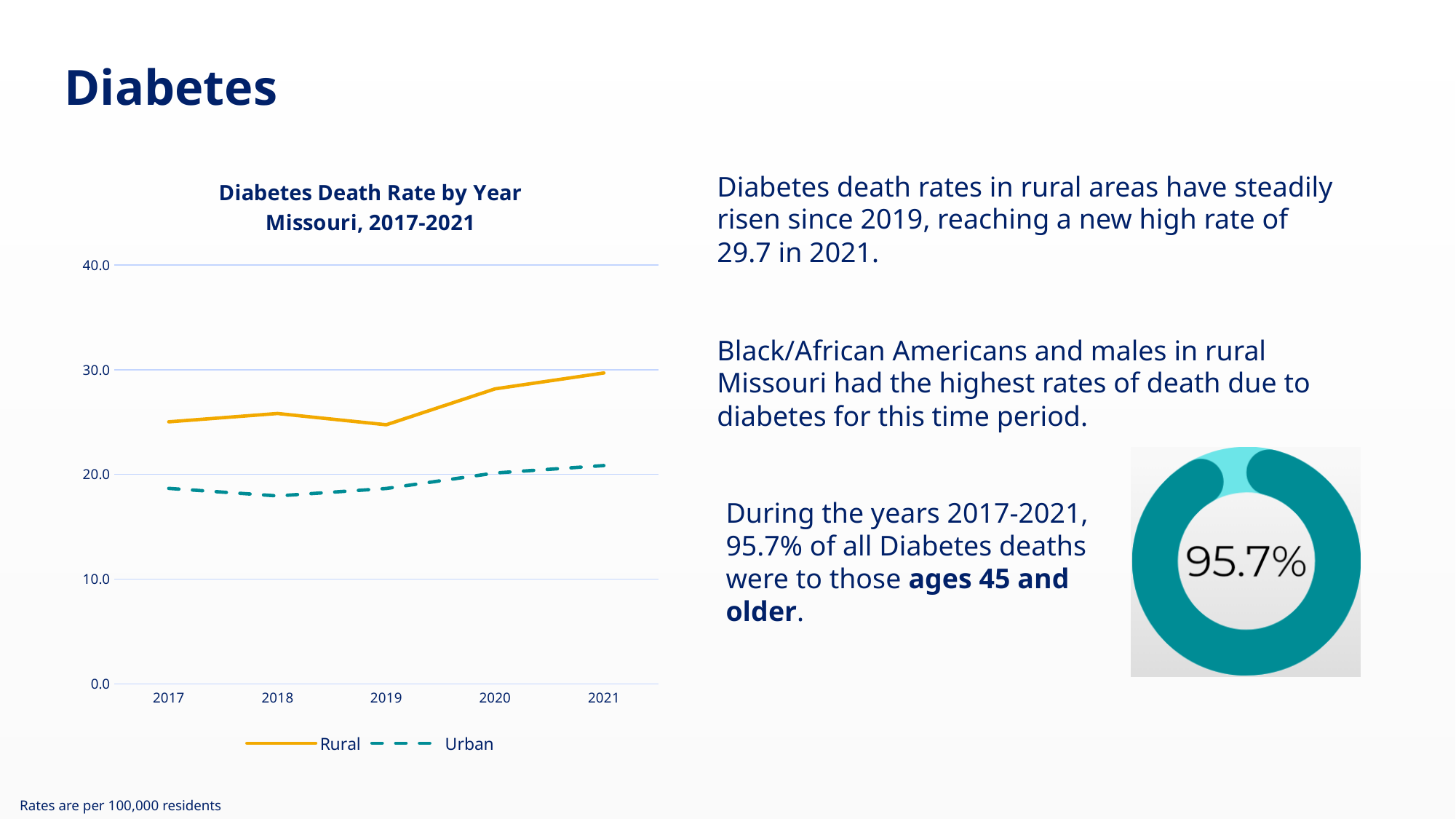
Is the Rural value for 2019 greater or less than 20.0? greater In which year is the Rural diabetes death rate highest? 2021 Is the Rural value for 2020 greater or less than 30.0? less What is the title of the line chart? Diabetes Death Rate by Year Missouri, 2017-2021 Which series in the chart is drawn with a dashed line? Urban Does the Rural diabetes death rate rise or fall from 2019 to 2021? rise How many series does the legend of the Diabetes Death Rate by Year chart list? 2 What kind of chart is shown on the slide? line chart In which year is the Urban diabetes death rate lowest? 2018 How many years are plotted on the x axis of the chart? 5 Is the Urban value for 2018 greater or less than 20.0? less In 2021, which series has the higher diabetes death rate, Rural or Urban? Rural